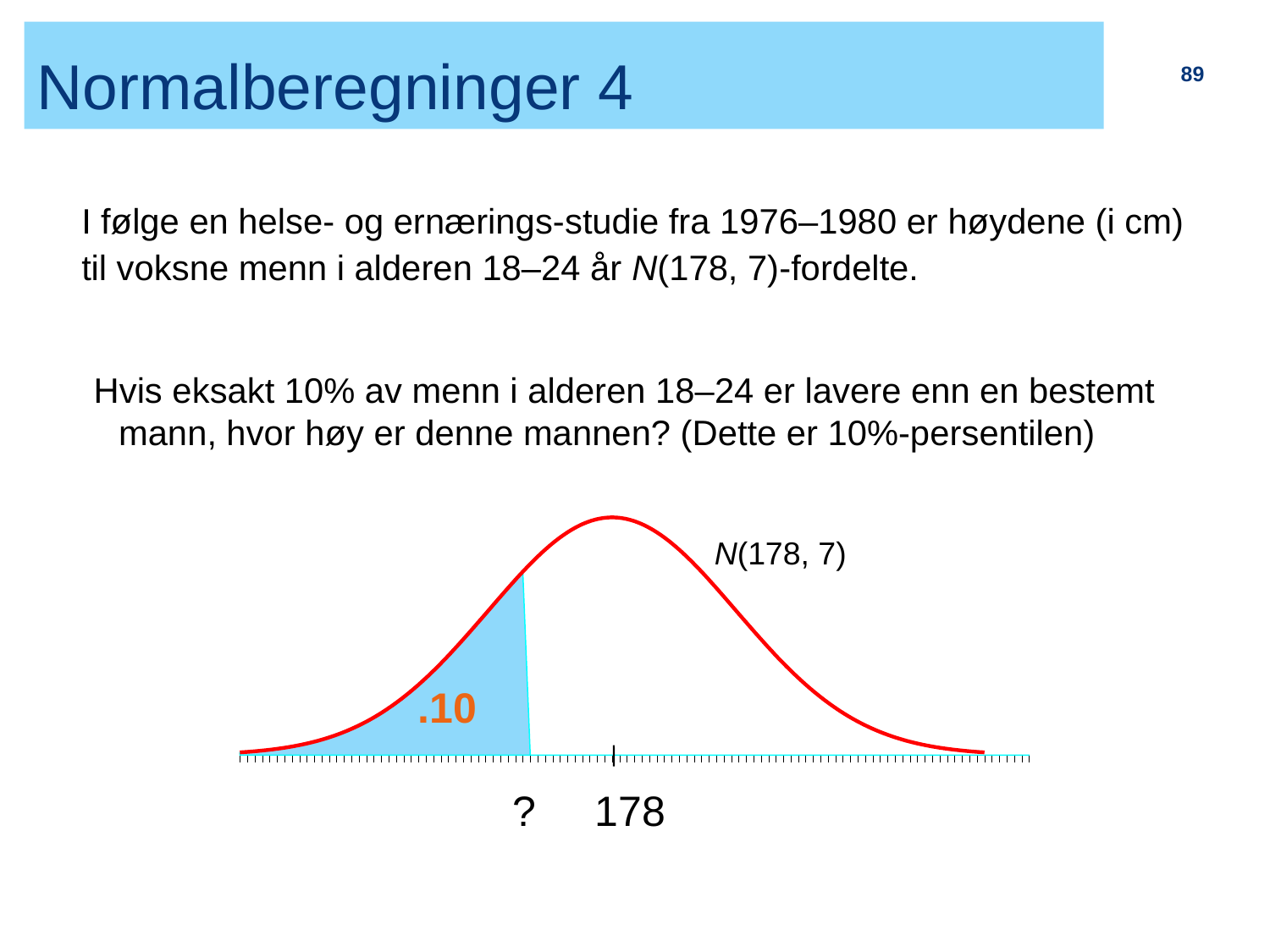
What symbol is printed on the axis below the right edge of the shaded region? ? What value is marked at the centre tick of the horizontal axis under the curve? 178 What value is printed inside the shaded region of the curve? .10 What colour is the shaded region under the curve? light blue What kind of chart is shown on the slide? a normal distribution curve Is the shaded area under the curve greater or less than half of the total area? less What distribution label is written next to the curve? N(178, 7) Is the shaded region located to the left or to the right of 178 on the axis? left What colour is the curve drawn in? red